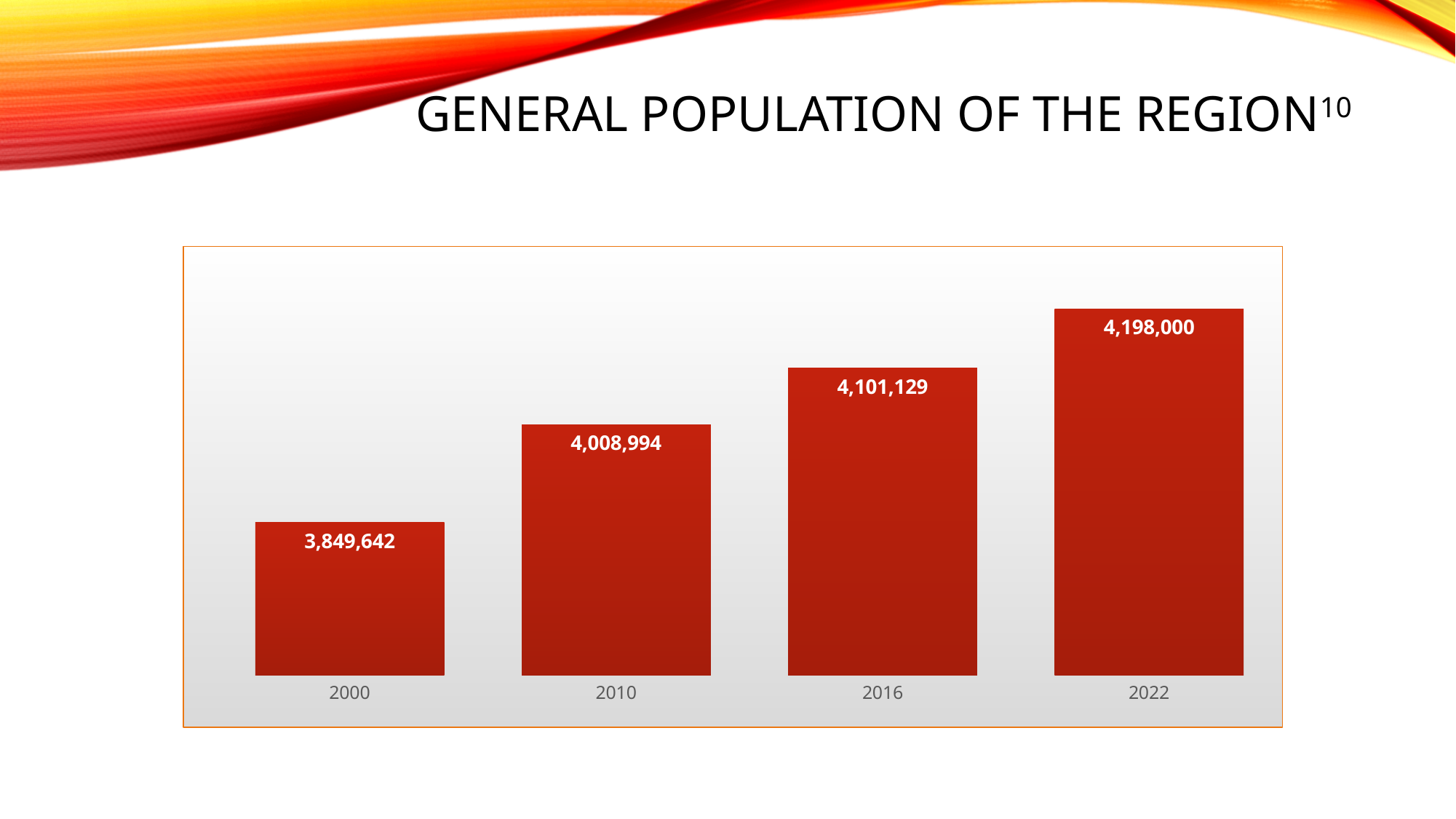
Which year has the highest population value? 2022 How many years are shown on the chart? 4 What is the difference between the population values for 2022 and 2000? 348,358 What kind of chart is shown on the slide? Bar chart Which year has the larger population value, 2016 or 2010? 2016 What is the population value shown for 2010? 4,008,994 What is the population value shown for 2022? 4,198,000 What is the population value shown for 2000? 3,849,642 What is the difference between the population values for 2010 and 2000? 159,352 Do the population values rise or fall from 2000 to 2022? Rise Which year has the lowest population value? 2000 What is the population value shown for 2016? 4,101,129